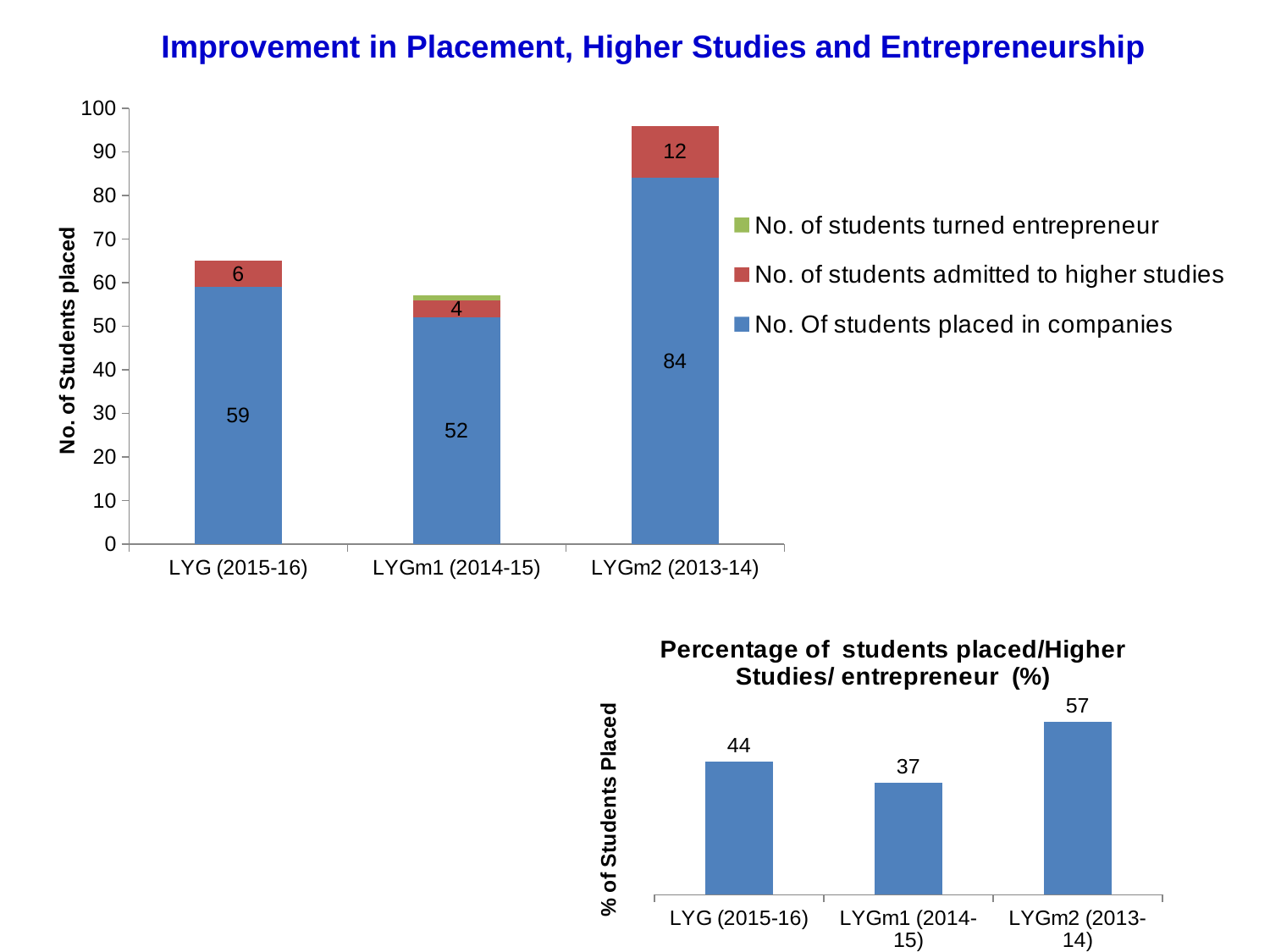
In the bottom chart titled 'Percentage of students placed/Higher Studies/ entrepreneur (%)', what is the value for LYGm1 (2014-15)? 37 In the top chart, how many students were placed in companies for LYGm1 (2014-15)? 52 In the top chart, which series is shown in green? No. of students turned entrepreneur In the bottom chart titled 'Percentage of students placed/Higher Studies/ entrepreneur (%)', which category has the lowest value? LYGm1 (2014-15) In the top chart, how many series does the legend list? 3 In the top chart, which category has the highest number of students placed in companies? LYGm2 (2013-14) In the top chart, how many students were admitted to higher studies for LYG (2015-16)? 6 In the bottom chart titled 'Percentage of students placed/Higher Studies/ entrepreneur (%)', what is the difference between LYGm2 (2013-14) and LYG (2015-16)? 13 In the top chart, how many students were placed in companies for LYGm2 (2013-14)? 84 In the top chart, what is the difference between the number of students placed in companies for LYGm2 (2013-14) and LYG (2015-16)? 25 In the top chart, what is the total height of the stacked bar for LYGm2 (2013-14)? 96 What kind of chart is the bottom chart on the slide? Bar chart